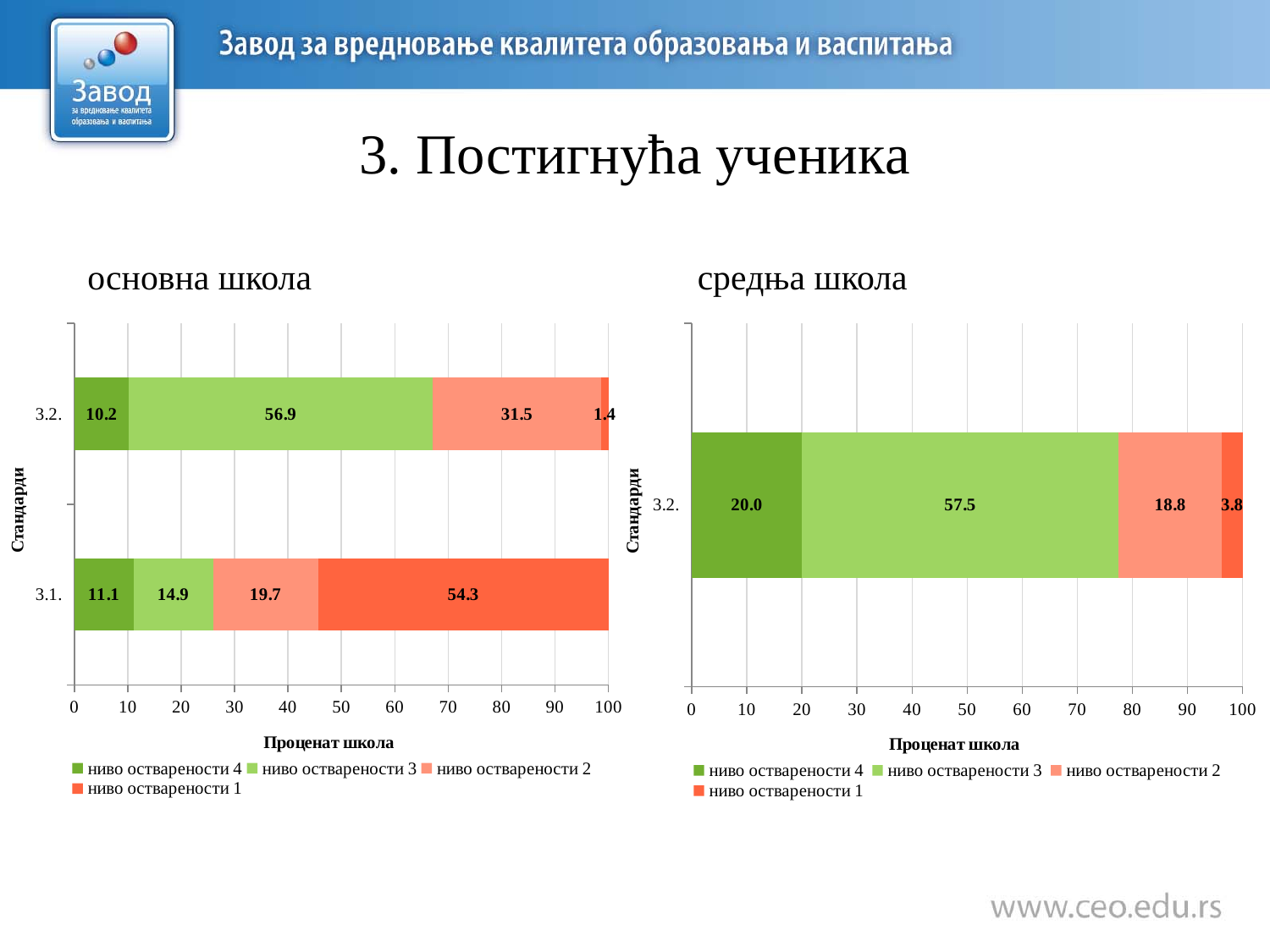
What type of chart is the 'средња школа' chart? Stacked bar chart How many standards (categories) are shown in the 'основна школа' chart? 2 In the 'основна школа' chart, what is the value of 'ниво остварености 1' for standard 3.1.? 54.3 In the 'средња школа' chart, what is the value of 'ниво остварености 2' for standard 3.2.? 18.8 In the 'основна школа' chart, which level has the largest share for standard 3.1.? ниво остварености 1 What is the x-axis title of the 'основна школа' chart? Проценат школа In the 'основна школа' chart, which is larger for standard 3.1.: 'ниво остварености 2' or 'ниво остварености 3'? ниво остварености 2 In the 'средња школа' chart, what is the difference between 'ниво остварености 3' and 'ниво остварености 4' for standard 3.2.? 37.5 In the 'средња школа' chart, what is the value of 'ниво остварености 4' for standard 3.2.? 20.0 In the 'основна школа' chart, which level has the smallest share for standard 3.2.? ниво остварености 1 In the 'основна школа' chart, what is the value of 'ниво остварености 3' for standard 3.2.? 56.9 How many series does the legend of the 'средња школа' chart list? 4